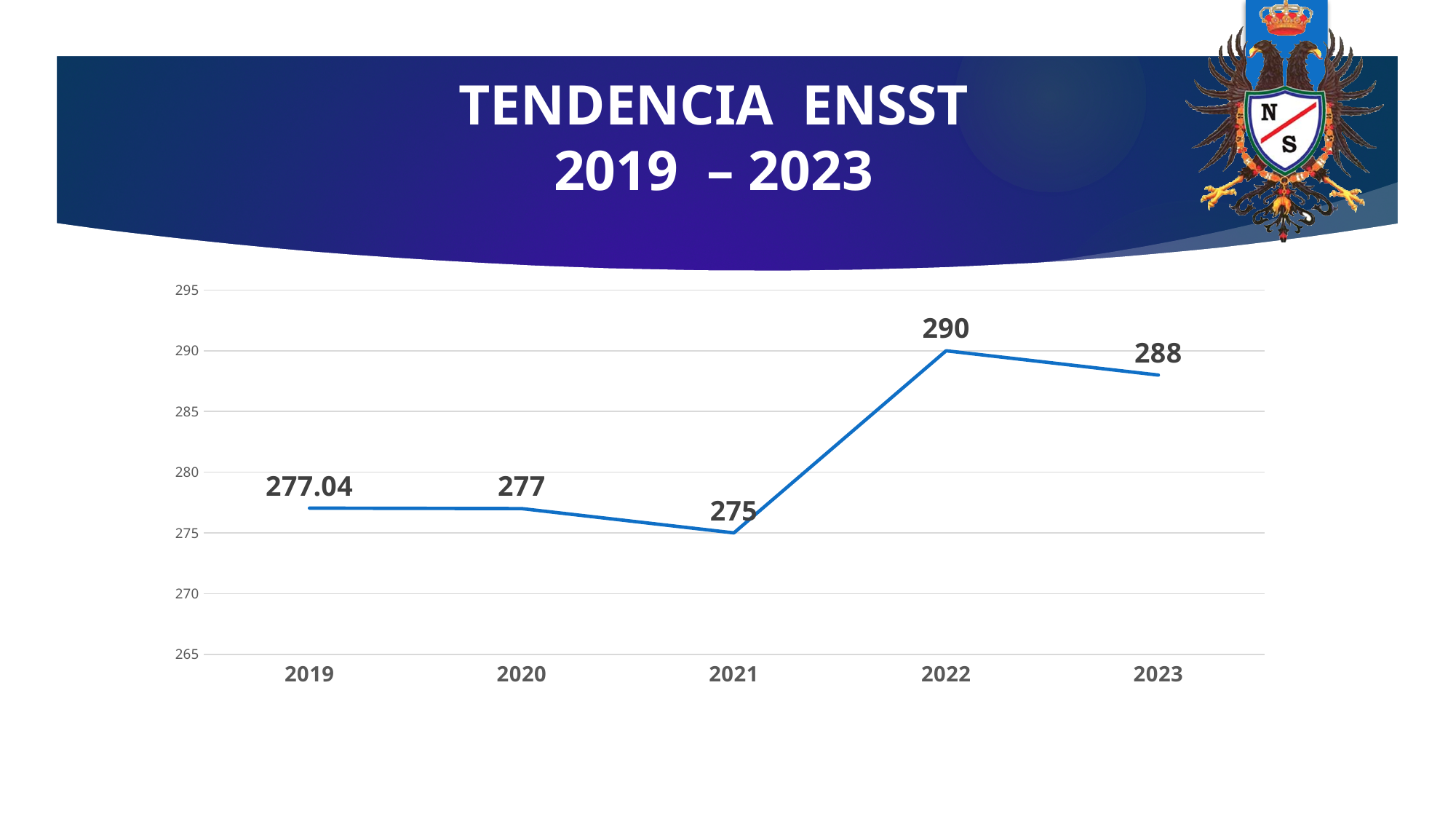
What is the value for 2021? 275 What kind of chart is shown on the slide? line chart What is the difference between the values for 2022 and 2021? 15 What is the value for 2019? 277.04 What is the value for 2022? 290 Which is larger, the value for 2020 or the value for 2023? 2023 What is the difference between the values for 2022 and 2023? 2 What is the value for 2023? 288 Which year has the highest value? 2022 What is the title of the slide? TENDENCIA ENSST 2019 – 2023 How many years are plotted on the chart? 5 Which year has the lowest value? 2021